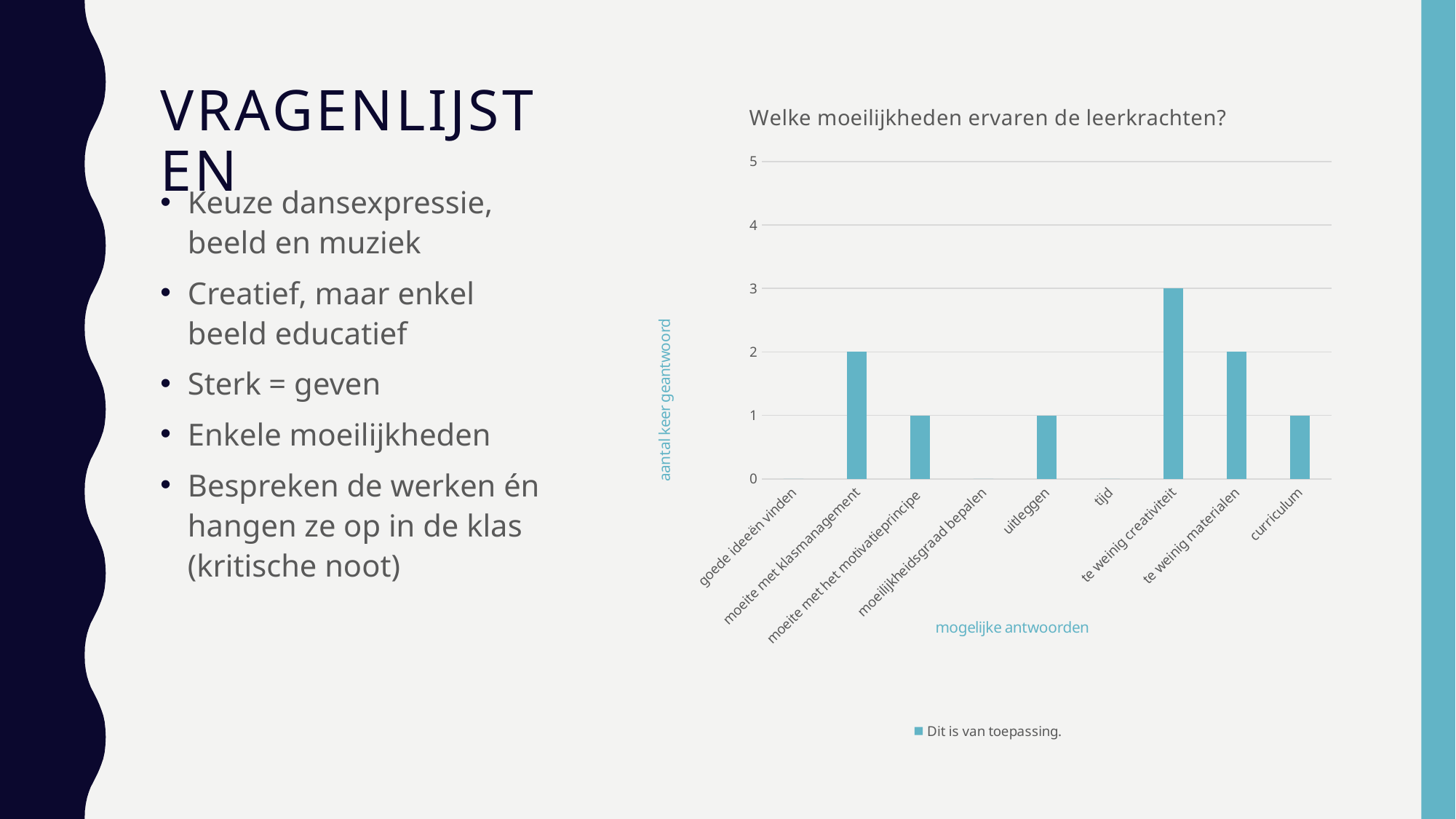
How many categories are shown on the x axis of the chart? 9 What is the value for 'tijd'? 0 Which is larger, the value for 'moeite met klasmanagement' or the value for 'curriculum'? moeite met klasmanagement How many series does the chart legend list? 1 Which category has the highest value in the chart? te weinig creativiteit What is the title of the chart? Welke moeilijkheden ervaren de leerkrachten? What is the value for 'moeite met klasmanagement'? 2 What kind of chart is shown on the slide? bar chart What is the difference between the values for 'te weinig creativiteit' and 'te weinig materialen'? 1 What is the value for 'uitleggen'? 1 What is the value for 'te weinig creativiteit'? 3 What is the label of the y axis of the chart? aantal keer geantwoord